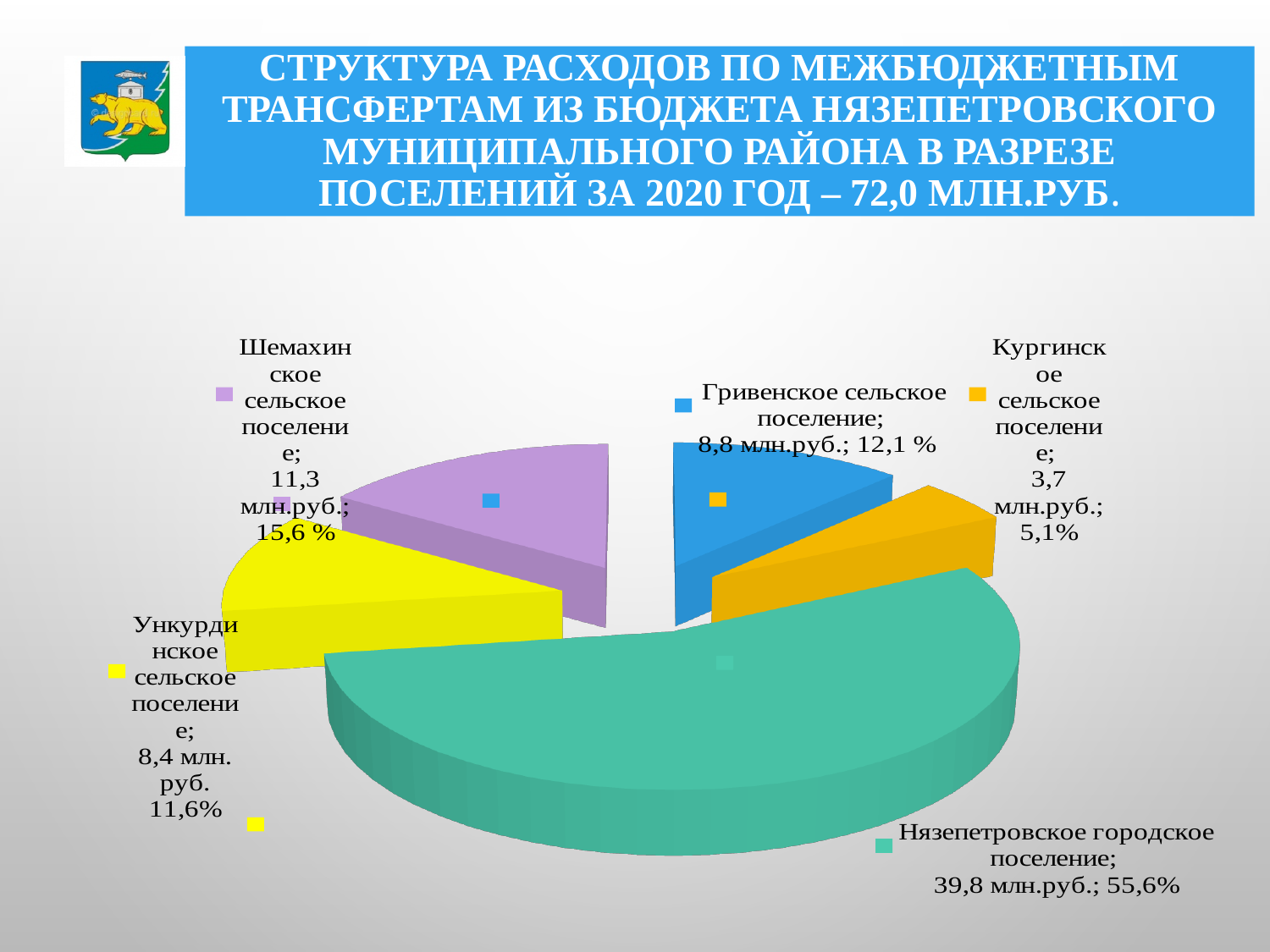
Which settlement has the smallest slice of the pie? Кургинское сельское поселение What percentage is shown for Гривенское сельское поселение? 12,1 % What share of the pie does Шемахинское сельское поселение have? 15,6 % What amount is shown for Нязепетровское городское поселение? 39,8 млн.руб. What amount is shown for Кургинское сельское поселение? 3,7 млн.руб. What total amount of intergovernmental transfers for 2020 is stated in the chart title? 72,0 млн.руб. How many slices does the pie chart have? 5 What kind of chart is shown on the slide? Pie chart What is the difference in млн.руб. between Нязепетровское городское поселение and Ункурдинское сельское поселение? 31,4 млн.руб. What colour is the slice for Ункурдинское сельское поселение? Yellow Which is larger, the amount for Шемахинское сельское поселение or for Гривенское сельское поселение? Шемахинское сельское поселение Which settlement has the largest slice of the pie? Нязепетровское городское поселение